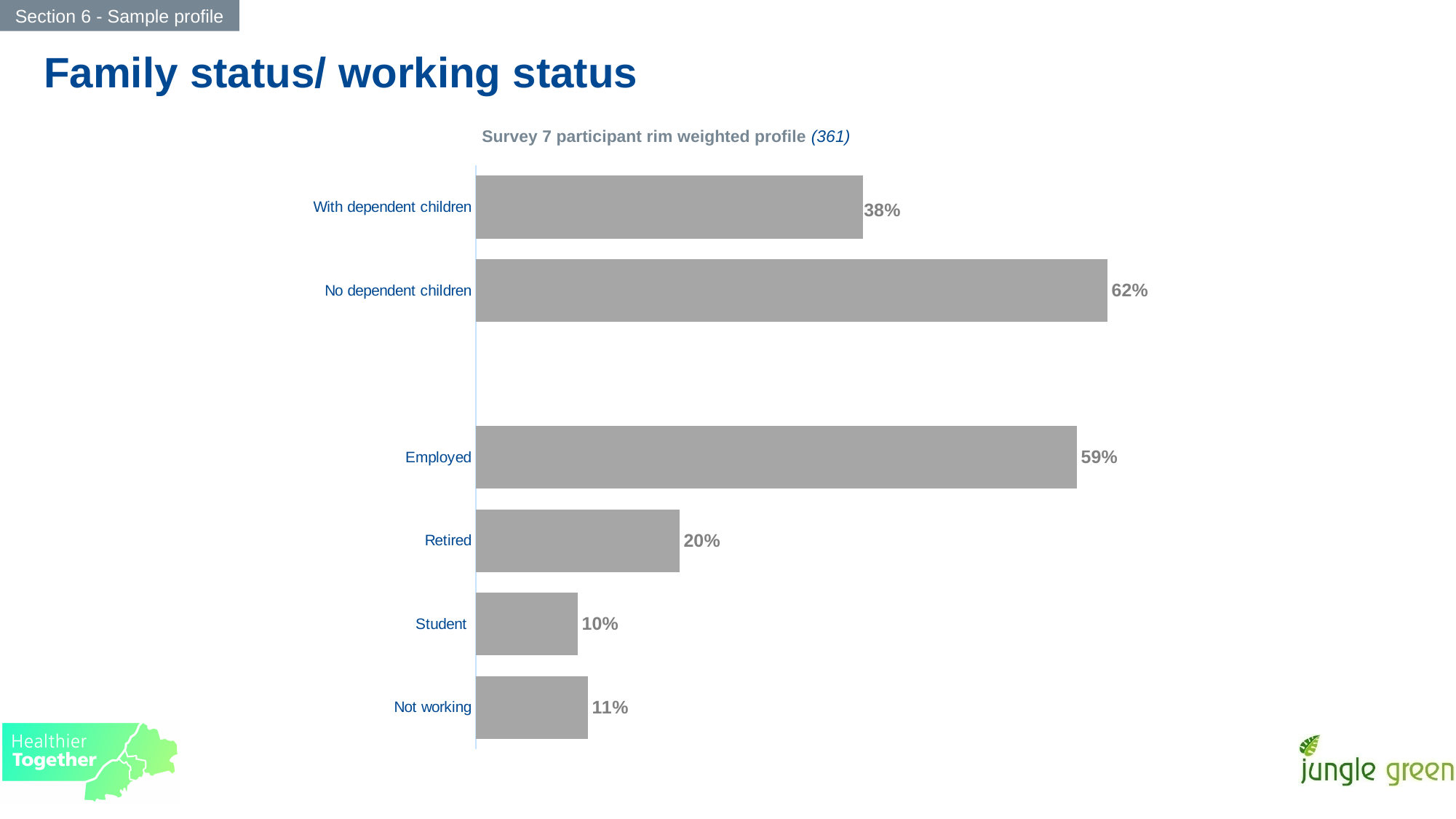
Which category has the highest value? No dependent children What is the value for Employed? 59% What is the value for Not working? 11% What is the value for Retired? 20% How many categories are shown in the chart? 6 What is the value for With dependent children? 38% Which category has the lowest value? Student Which is larger, the value for Employed or the value for Retired? Employed What is the value for Student? 10% What is the value for No dependent children? 62% What is the difference between the values for No dependent children and With dependent children? 24% What kind of chart is shown on the slide? Bar chart